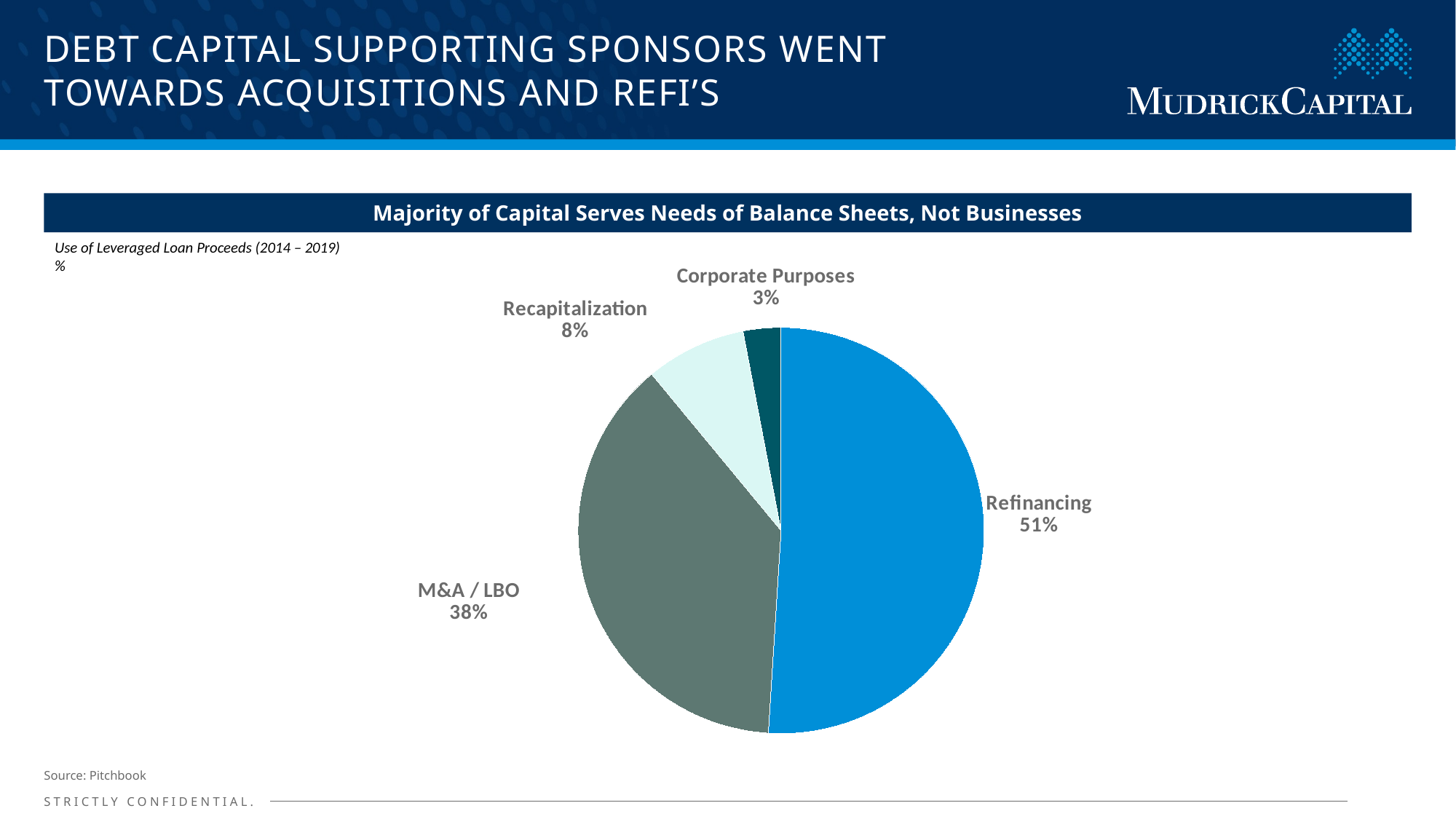
What share of leveraged loan proceeds went to Recapitalization? 8% What kind of chart is shown on the slide? Pie chart Which use of proceeds has the smallest share of the pie? Corporate Purposes How many categories are shown in the pie chart? 4 Which is larger, the share for Recapitalization or the share for Corporate Purposes? Recapitalization Which use of proceeds has the largest share of the pie? Refinancing What is the combined share of Recapitalization and Corporate Purposes? 11% What share of leveraged loan proceeds went to Refinancing? 51% What is the difference in percentage points between Refinancing and M&A / LBO? 13 What share of leveraged loan proceeds went to Corporate Purposes? 3% What period does the chart's subtitle say the leveraged loan proceeds data covers? 2014 – 2019 What share of leveraged loan proceeds went to M&A / LBO? 38%